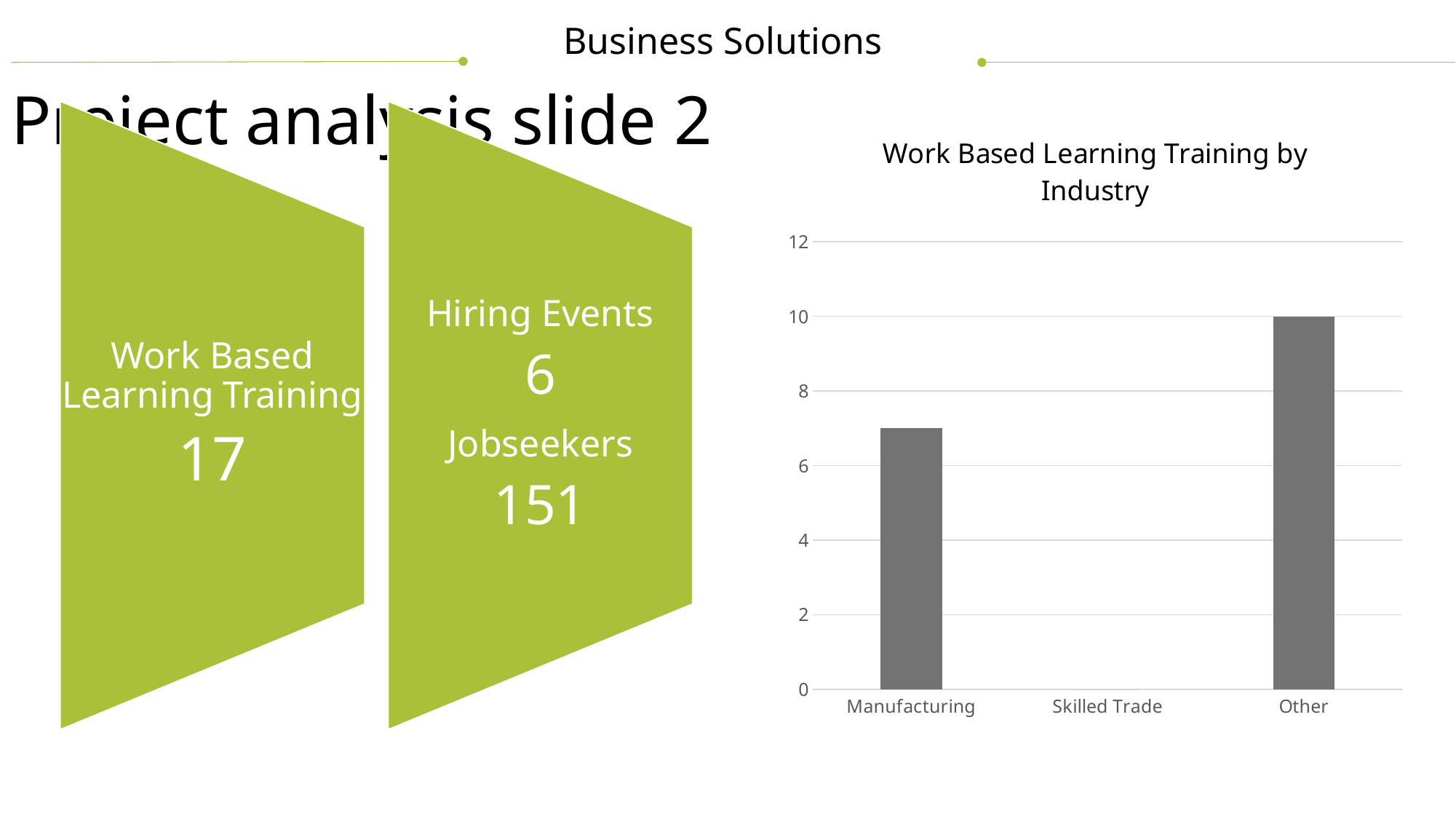
Which industry has the lowest value in the chart? Skilled Trade Which is larger, the value for Manufacturing or the value for Other? Other What is the title of the chart? Work Based Learning Training by Industry Is the value for Manufacturing greater or less than 8? less What is the highest value shown on the chart's vertical axis? 12 Is the value for Other greater or less than 8? greater What is the value for Other in the chart? 10 What type of chart is shown on the slide? bar chart How many industry categories are shown on the x axis of the chart? 3 Which industry has the highest value in the chart? Other Is the value for Manufacturing greater or less than 6? greater